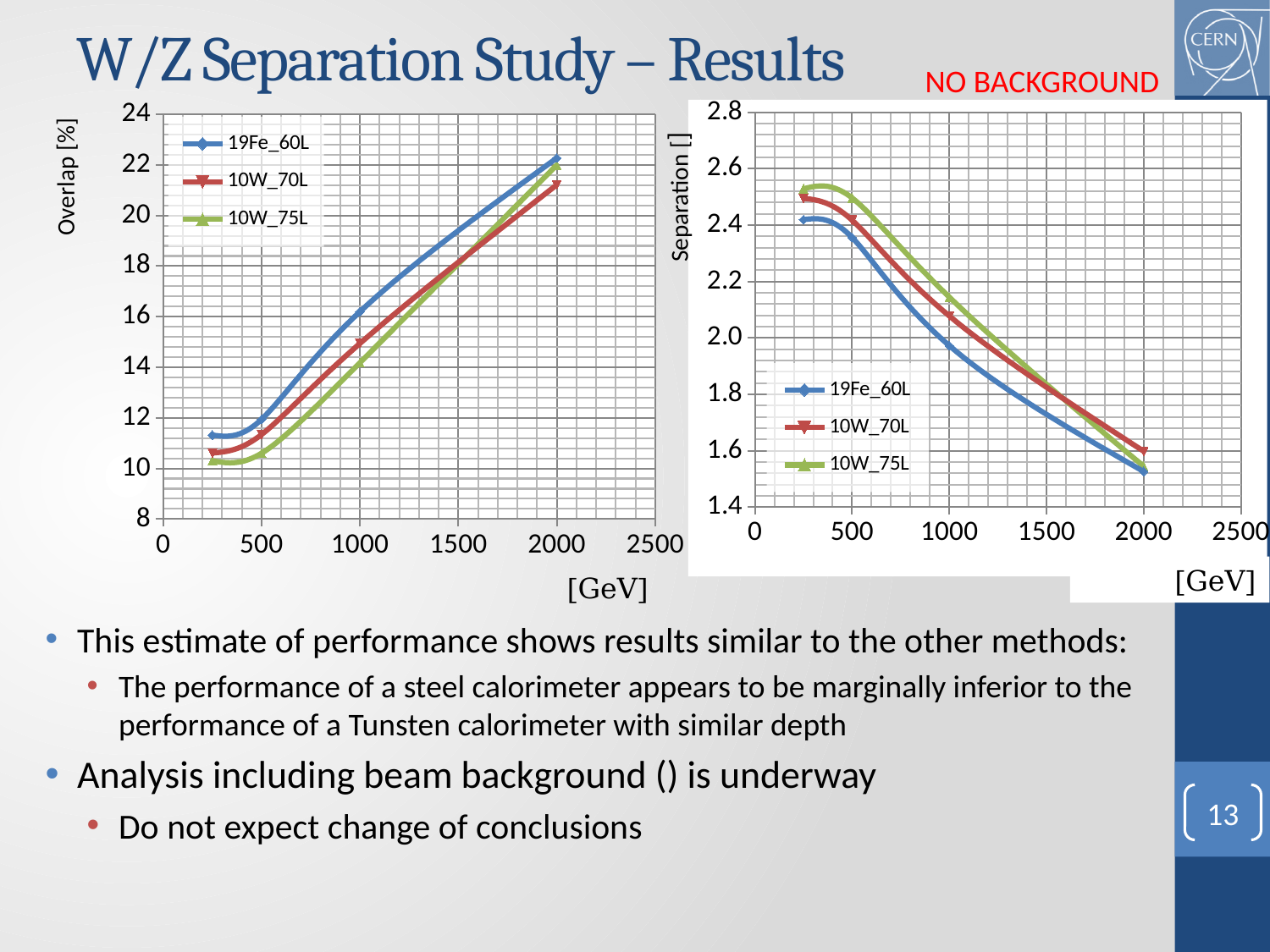
In the right chart (Separation), is the value for 19Fe_60L at 2000 GeV greater or less than 1.6? less In the left chart (Overlap [%]), which series has the highest value at 1000 GeV? 19Fe_60L In the left chart (Overlap [%]), is the value for 19Fe_60L at 1000 GeV greater or less than 14? greater How many series does the legend of the right chart (Separation) list? 3 In the right chart (Separation), at 1000 GeV, which is larger: 10W_75L or 19Fe_60L? 10W_75L In the right chart (Separation), do the values rise or fall as the energy in GeV increases? fall What type of chart is the left chart (Overlap [%])? line chart What is the y-axis label of the left chart? Overlap [%] In the left chart (Overlap [%]), do the values rise or fall as the energy in GeV increases? rise In the left chart (Overlap [%]), is the value for 10W_75L at 250 GeV greater or less than 12? less In the right chart (Separation), which series has the lowest value at 1000 GeV? 19Fe_60L